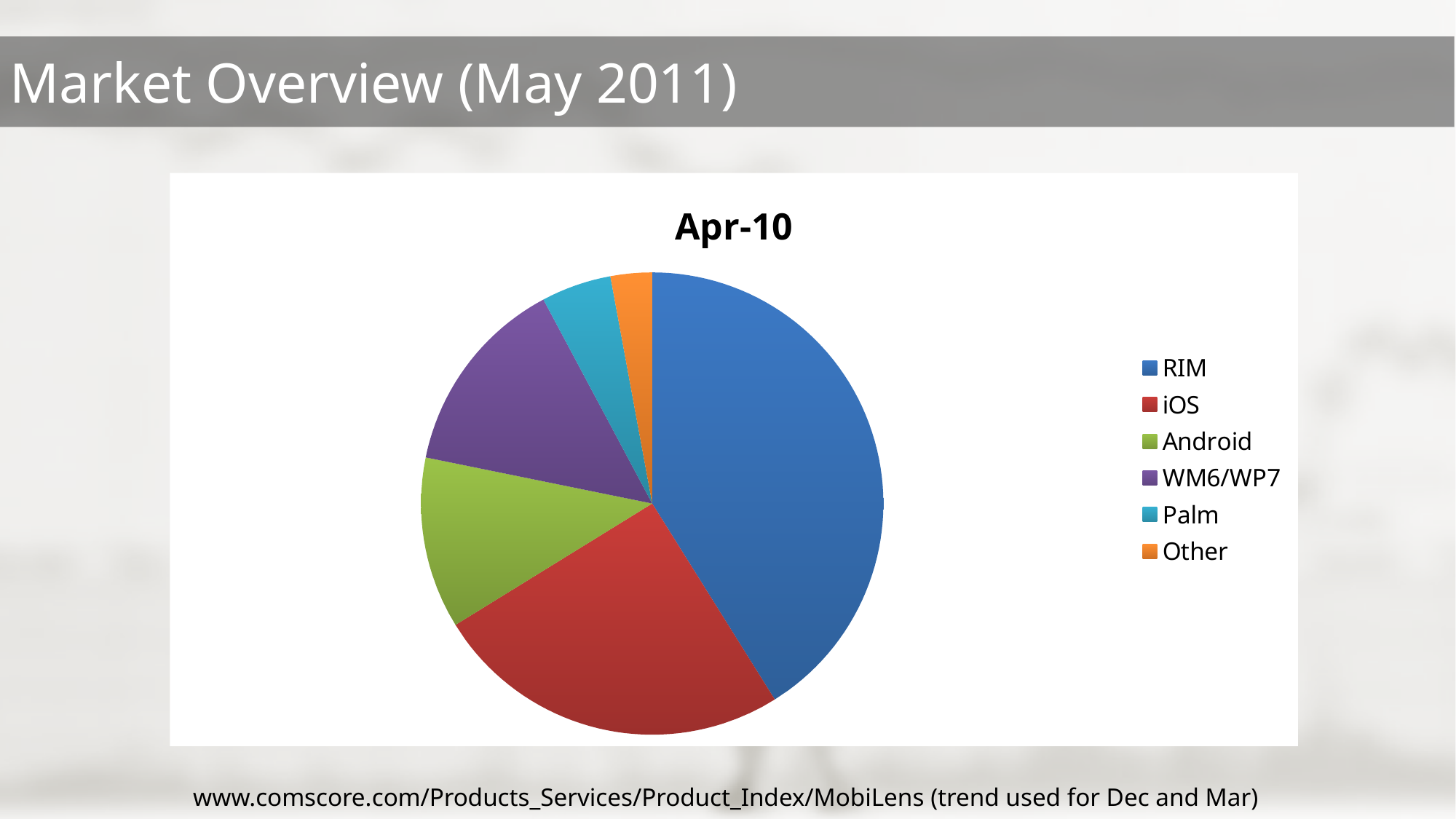
Which slice is larger, WM6/WP7 or Palm? WM6/WP7 Which slice is larger, RIM or iOS? RIM What kind of chart is shown on the slide? pie chart How many slices does the pie chart have? 6 What is the title of the pie chart? Apr-10 Which category has the second-largest slice of the pie? iOS Which slice is larger, iOS or Android? iOS How many entries does the legend list? 6 Which category is shown in blue in the pie chart? RIM Which category has the smallest slice of the pie? Other Which category has the largest slice of the pie? RIM